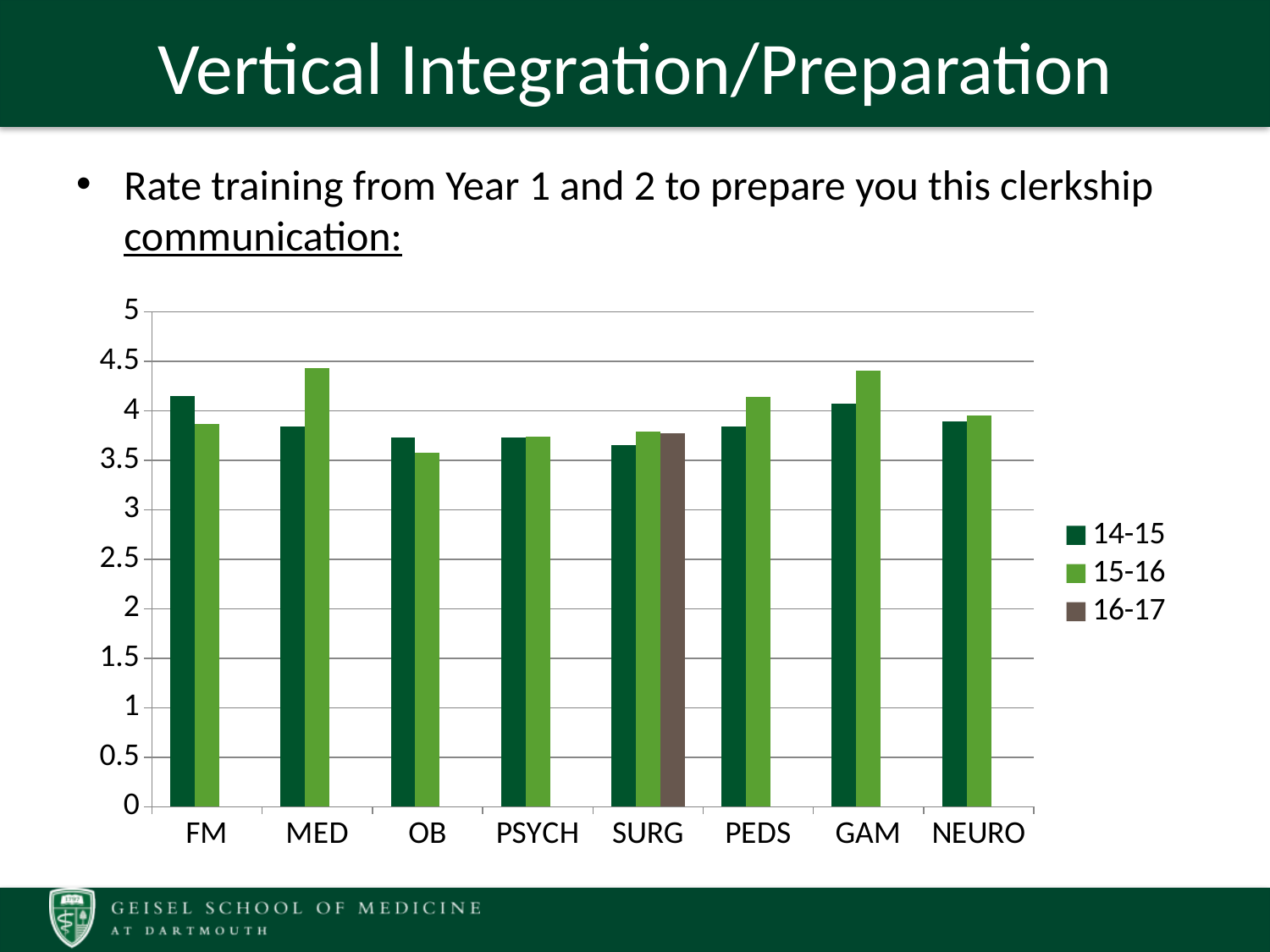
For FM, which series has the larger value, 14-15 or 15-16? 14-15 Is the 15-16 value for PEDS greater or less than 4? greater For GAM, which series has the larger value, 14-15 or 15-16? 15-16 What kind of chart is shown on the slide? bar chart How many clerkship categories are shown on the x axis? 8 Which category has the lowest 15-16 value? OB Is the 14-15 value for FM greater or less than 4? greater How many series does the legend list? 3 For MED, which series has the larger value, 14-15 or 15-16? 15-16 Which category is the only one with a 16-17 bar? SURG Is the 15-16 value for MED greater or less than 4? greater